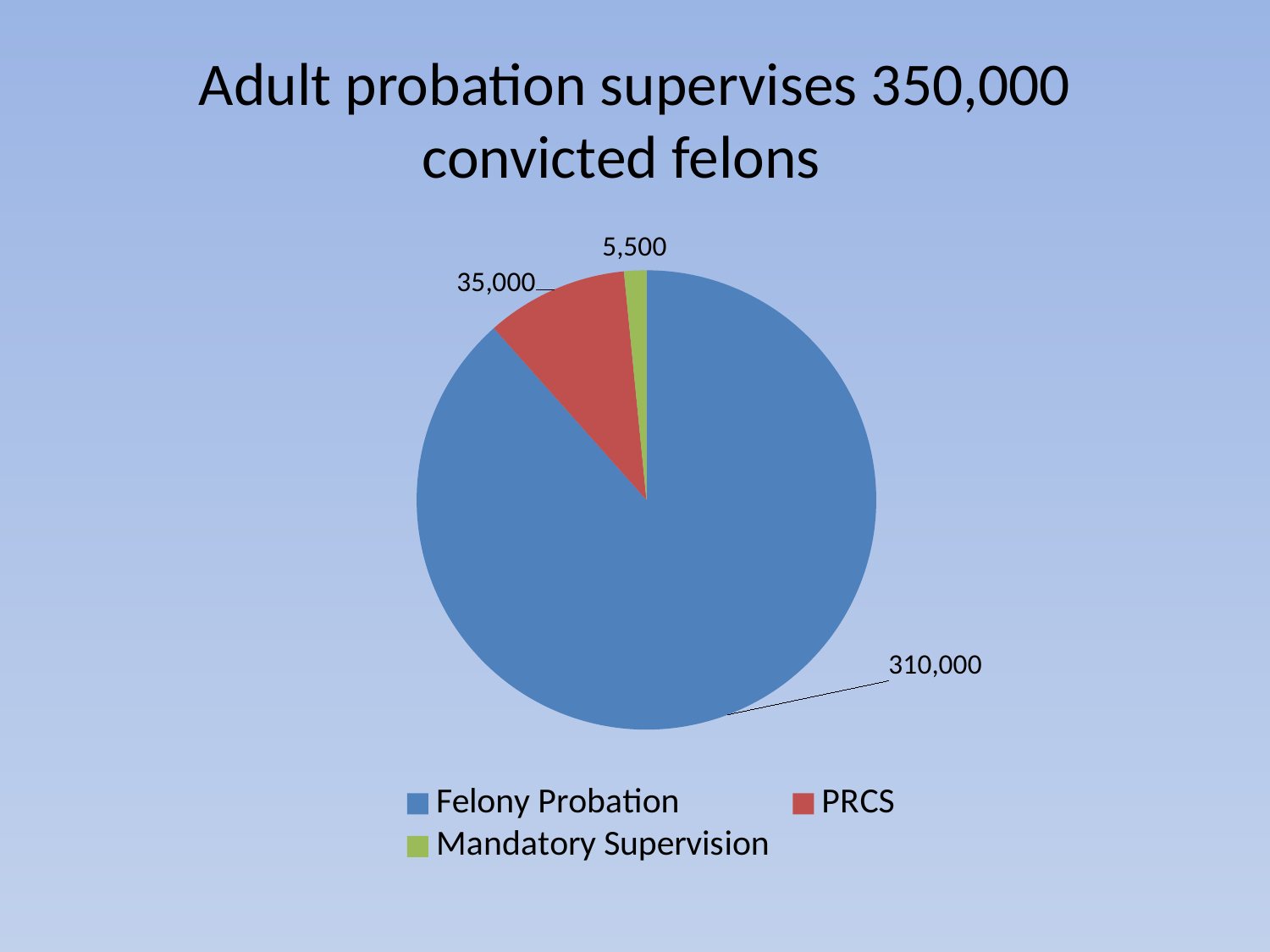
Which category has the largest slice of the pie? Felony Probation Which is larger, the value for PRCS or the value for Mandatory Supervision? PRCS What is the title of the slide? Adult probation supervises 350,000 convicted felons What is the difference between the Felony Probation value and the PRCS value? 275,000 Which category has the smallest slice of the pie? Mandatory Supervision What is the value for Felony Probation? 310,000 What is the value for PRCS? 35,000 What is the difference between the PRCS value and the Mandatory Supervision value? 29,500 What is the value for Mandatory Supervision? 5,500 How many categories does the pie chart show? 3 Which colour represents PRCS in the legend? Red What kind of chart is shown on the slide? Pie chart